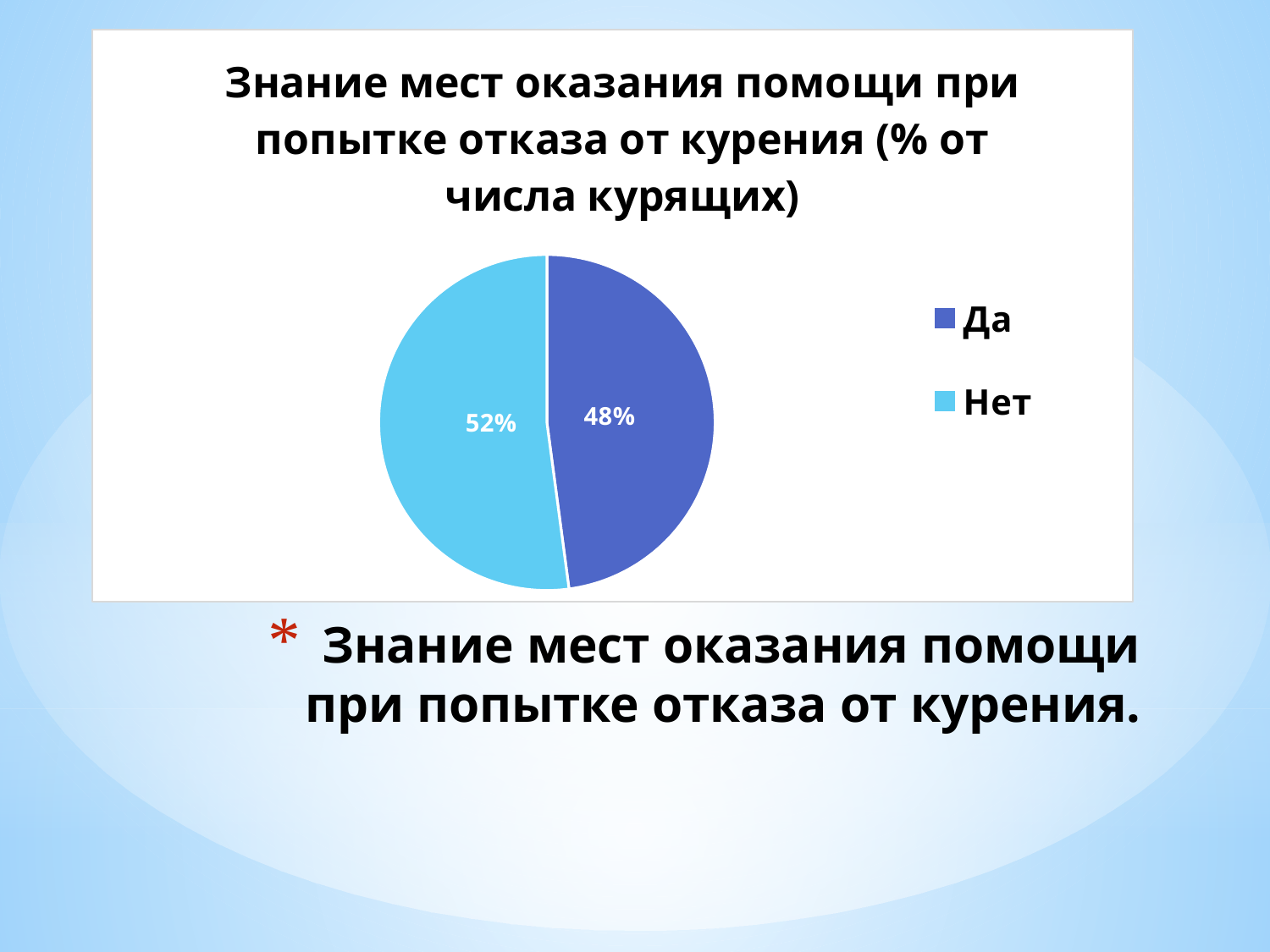
Is the share for "Да" greater or less than 50%? less Which category has the larger share of the pie: "Да" or "Нет"? Нет How many slices does the pie chart have? 2 Which category has the smallest slice in the pie chart? Да Which category has the largest slice in the pie chart? Нет What is the title of the chart? Знание мест оказания помощи при попытке отказа от курения (% от числа курящих) Which colour represents the "Да" category in the pie chart? Dark blue What percentage of smokers answered "Да" (Yes) in the pie chart? 48% What type of chart is shown on the slide? Pie chart How many entries does the legend list? 2 What percentage of smokers answered "Нет" (No) in the pie chart? 52% What is the difference in percentage points between the "Нет" and "Да" slices? 4